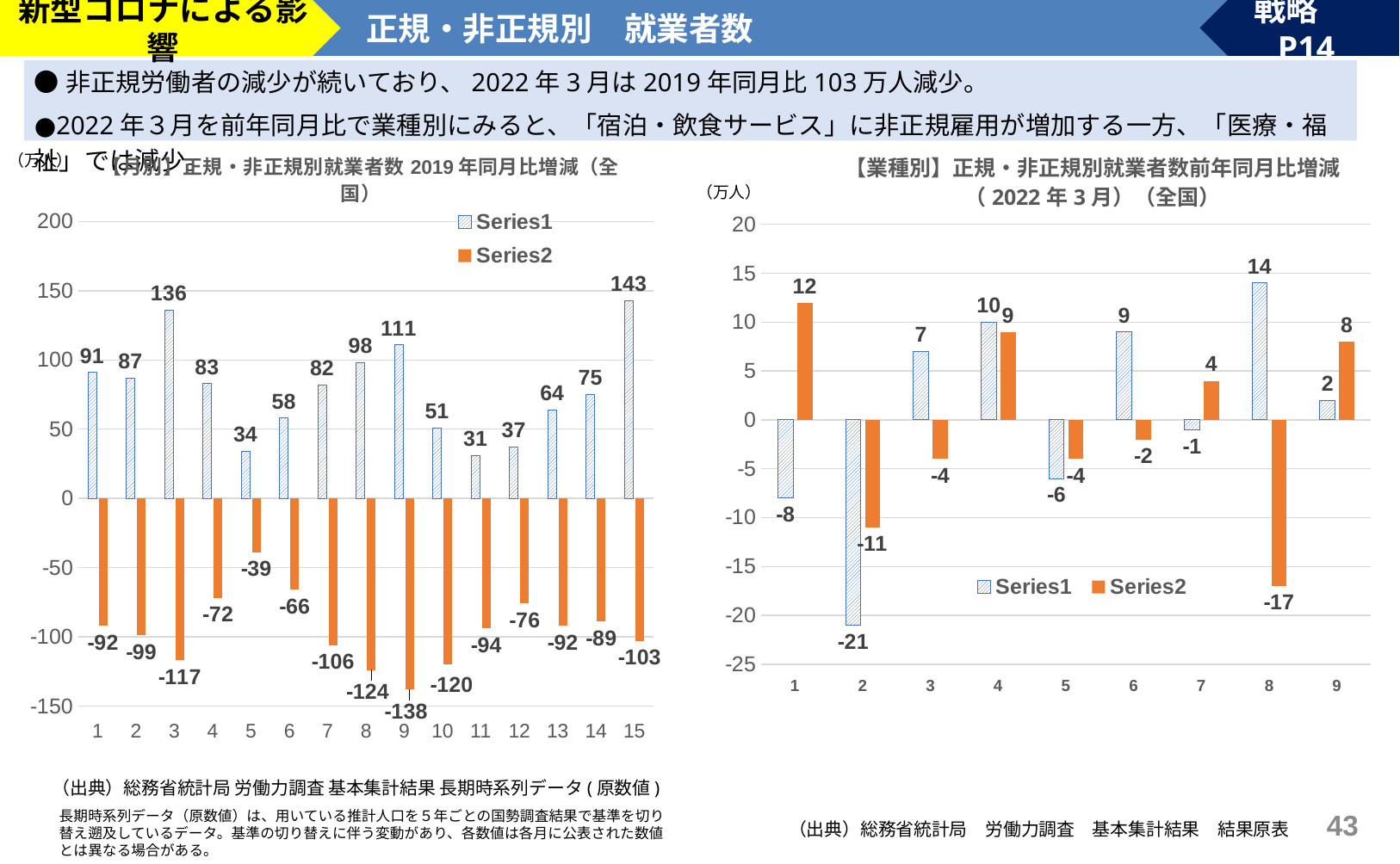
In the right chart, which category has the highest Series1 value? 8 In the right chart, what is the Series1 value for category 2? -21 In the left chart, what is the Series1 value for category 3? 136 In the left chart, which category has the highest Series1 value? 15 In the left chart, which category has the lowest Series2 value? 9 In the left chart, what is the difference between the Series1 values for category 15 and category 1? 52 In the left chart, what is the Series2 value for category 9? -138 How many series does the legend of the right chart list? 2 What type of chart is the right chart? bar chart In the right chart, is the Series2 value for category 1 larger or the Series2 value for category 9? category 1 How many categories are shown on the x axis of the left chart? 15 In the right chart, what is the Series2 value for category 8? -17